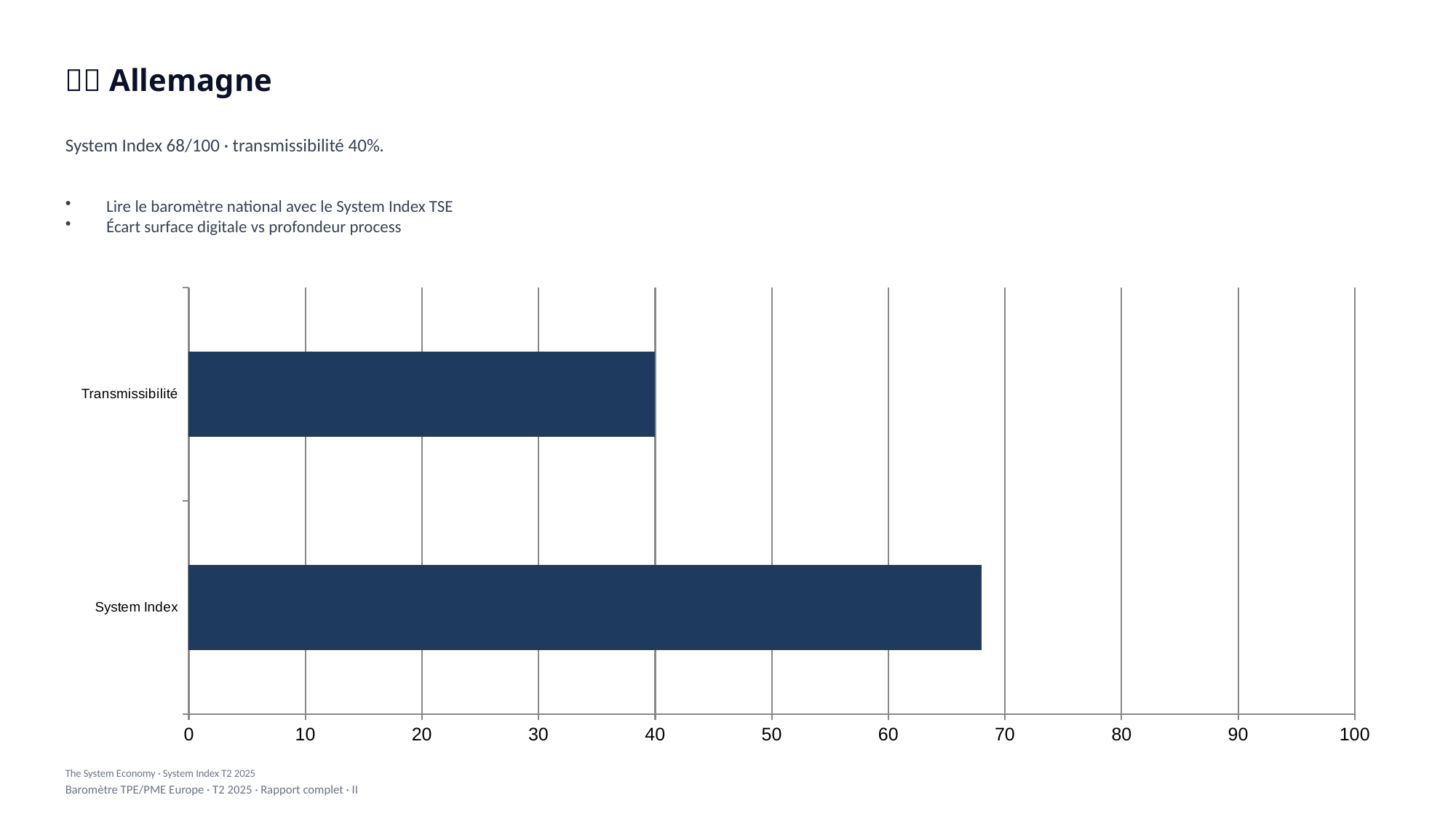
Are the bars in the chart horizontal or vertical? horizontal What kind of chart is shown on the slide? bar chart What is the maximum value shown on the x axis? 100 Is the value for System Index greater or less than 60? greater How many categories are plotted in the chart? 2 Which category has the lowest value? Transmissibilité Is the value for Transmissibilité greater or less than 50? less Is the value for System Index greater or less than 70? less Which is larger, System Index or Transmissibilité? System Index What is the value of the Transmissibilité bar? 40 Which category has the highest value? System Index